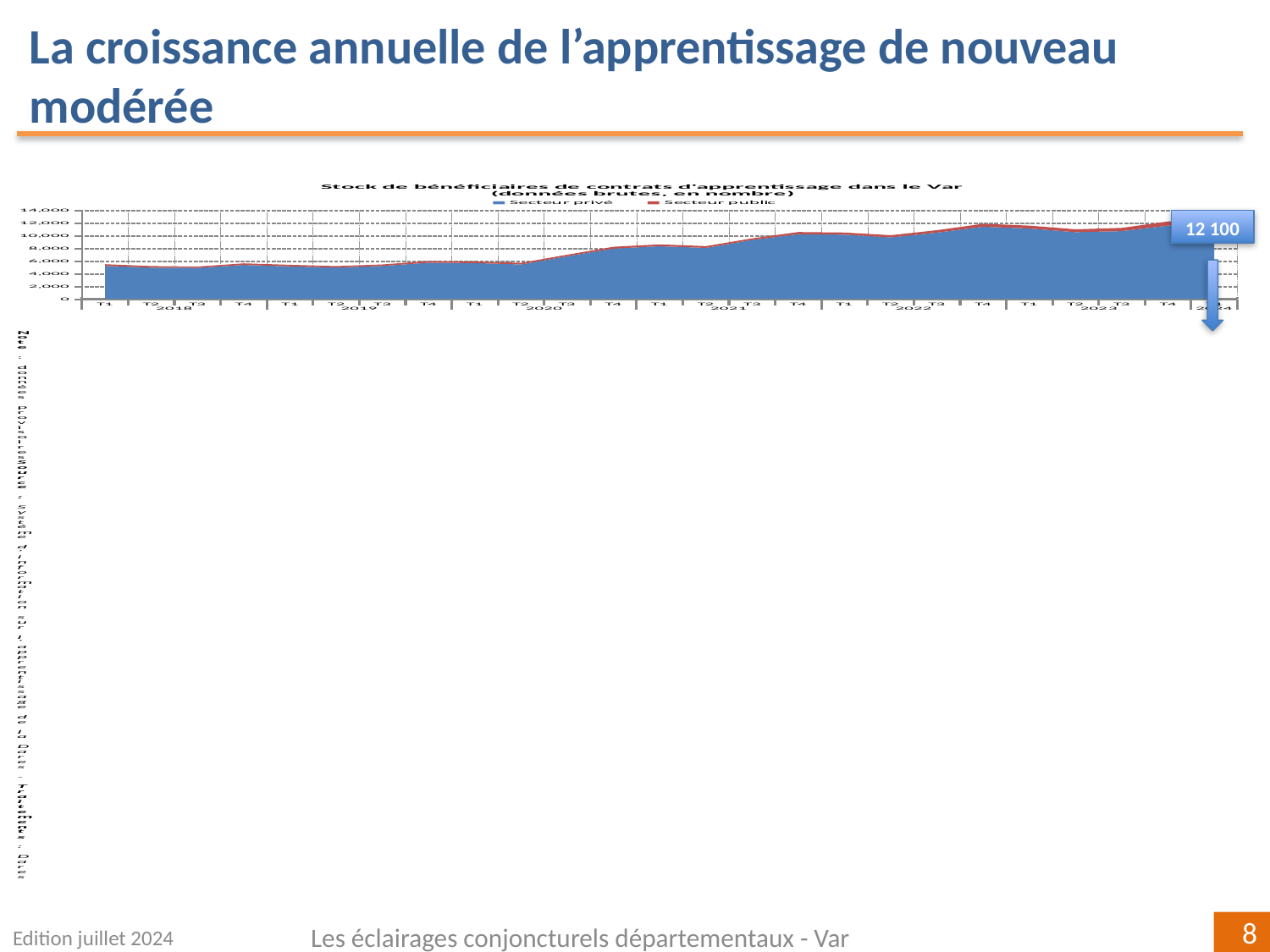
What is the title of the chart? Stock de bénéficiaires de contrats d'apprentissage dans le Var (données brutes, en nombre) How many year labels appear along the x axis? 7 Overall, does the stock of apprenticeship beneficiaries rise or fall from 2018 to 2024? rise How many series does the chart legend list? 2 Is the total stock at T1 2018 greater or less than 6,000? less Is the total stock at T1 2024 greater or less than 10,000? greater Which series accounts for the larger share of the stock, Secteur privé or Secteur public? Secteur privé What kind of chart is shown on the slide? Stacked area chart What are the two series named in the chart legend? Secteur privé and Secteur public Is the total stock at T2 2020 greater or less than 8,000? less Which is larger, the total stock at T1 2018 or at T1 2024? T1 2024 What value does the callout show for the most recent point (T1 2024)? 12 100